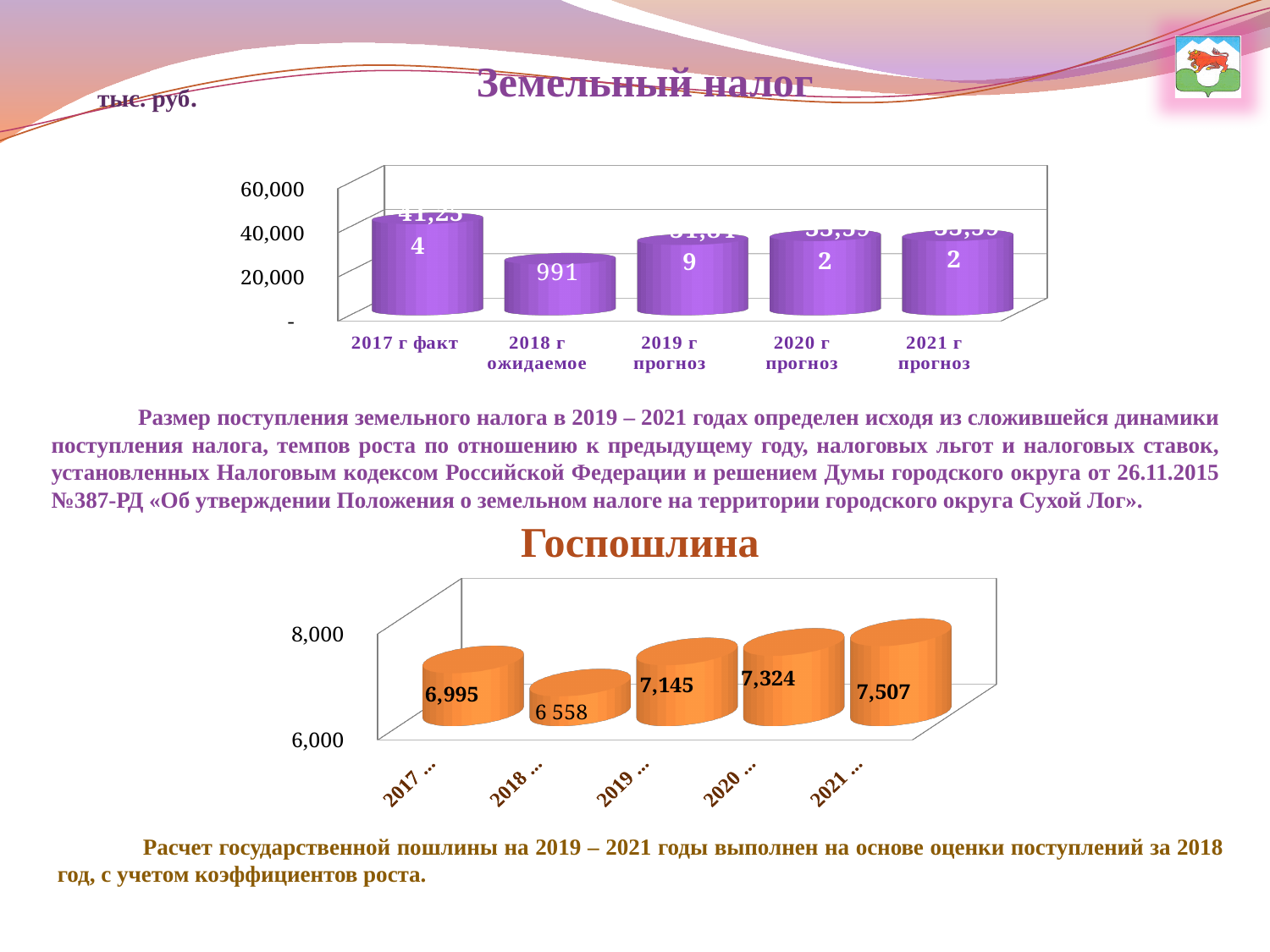
In the Госпошлина chart, what is the value for 2017? 6,995 In the Госпошлина chart, what is the difference between the 2021 value and the 2017 value? 512 How many bars does the Земельный налог chart have? 5 In the Госпошлина chart, which year has the highest value? 2021 In the Земельный налог chart, which category has the lowest value? 2018 г ожидаемое What kind of chart is the Госпошлина chart? bar chart In the Госпошлина chart, do the values rise or fall from 2018 to 2021? rise In the Госпошлина chart, which year has the lowest value? 2018 In the Госпошлина chart, what is the value for 2019? 7,145 In the Госпошлина chart, which is larger, the value for 2020 or the value for 2019? 2020 In the Земельный налог chart, is the value for 2019 г прогноз greater or less than 40,000? less In the Госпошлина chart, what is the value for 2021? 7,507